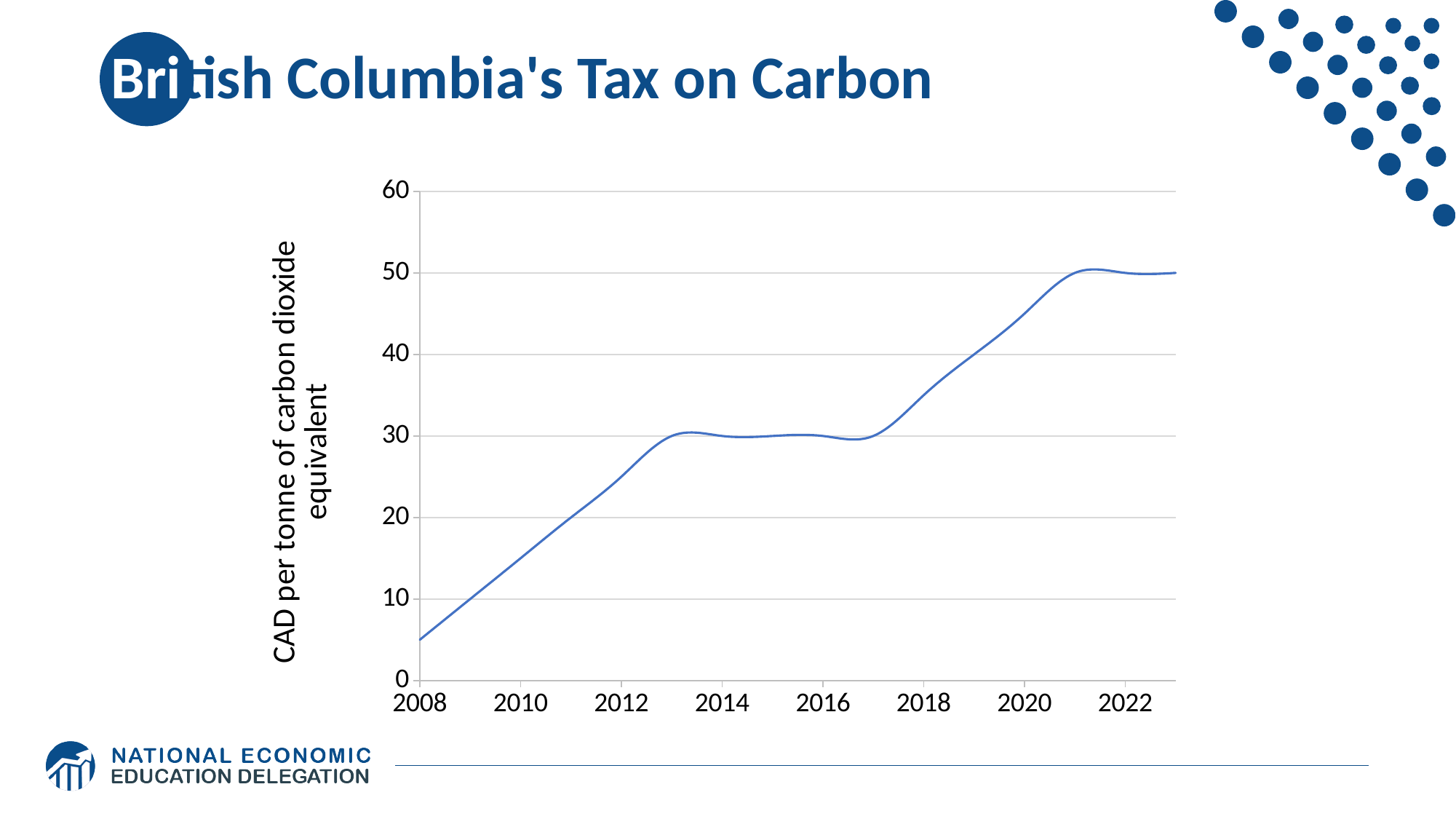
Is the value for 2008 greater or less than 10? less What is the title of the chart? British Columbia's Tax on Carbon What is the label on the vertical axis? CAD per tonne of carbon dioxide equivalent Is the value for 2020 greater or less than 40? greater Which year has the lowest value on the chart? 2008 Overall, do the values rise or fall from 2008 to 2022? rise Which is larger, the value for 2012 or the value for 2022? 2022 Is the value for 2018 greater or less than 30? greater What kind of chart is shown on the slide? line chart What is the value for 2022? 50 What is the value for 2014? 30